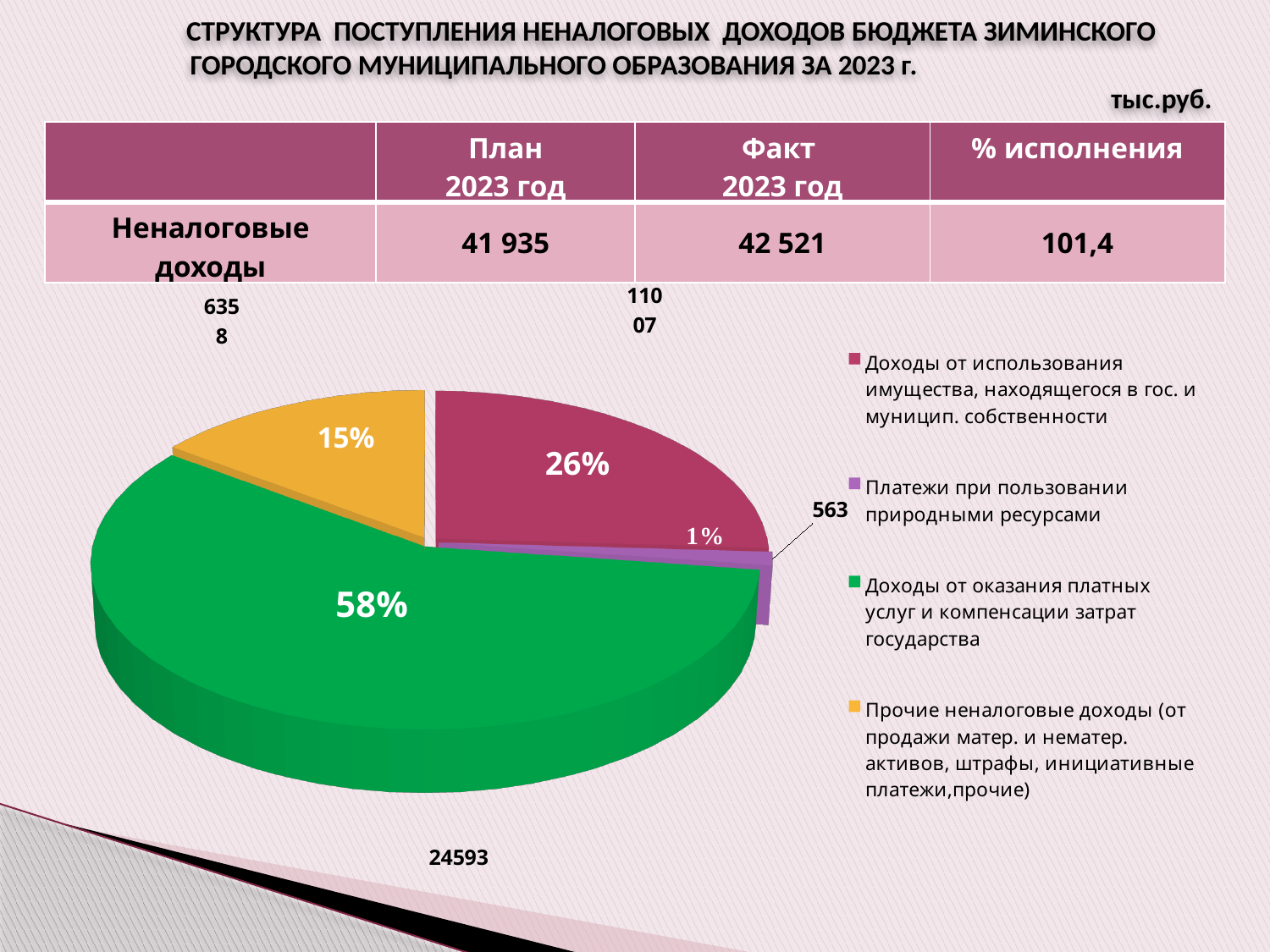
How many slices does the pie chart have? 4 What colour is the slice for 'Доходы от оказания платных услуг и компенсации затрат государства'? Green How many entries does the legend list? 4 Which category has the smallest slice of the pie? Платежи при пользовании природными ресурсами What share of the pie does 'Доходы от использования имущества, находящегося в гос. и муницип. собственности' represent? 26% What share of the pie does 'Платежи при пользовании природными ресурсами' represent? 1% Which is larger: the share of 'Прочие неналоговые доходы' or the share of 'Доходы от использования имущества'? Доходы от использования имущества What share of the pie does 'Доходы от оказания платных услуг и компенсации затрат государства' represent? 58% What kind of chart is shown on the slide? Pie chart Which category has the largest slice of the pie? Доходы от оказания платных услуг и компенсации затрат государства How many percentage points larger is the share of 'Доходы от оказания платных услуг' than the share of 'Доходы от использования имущества'? 32